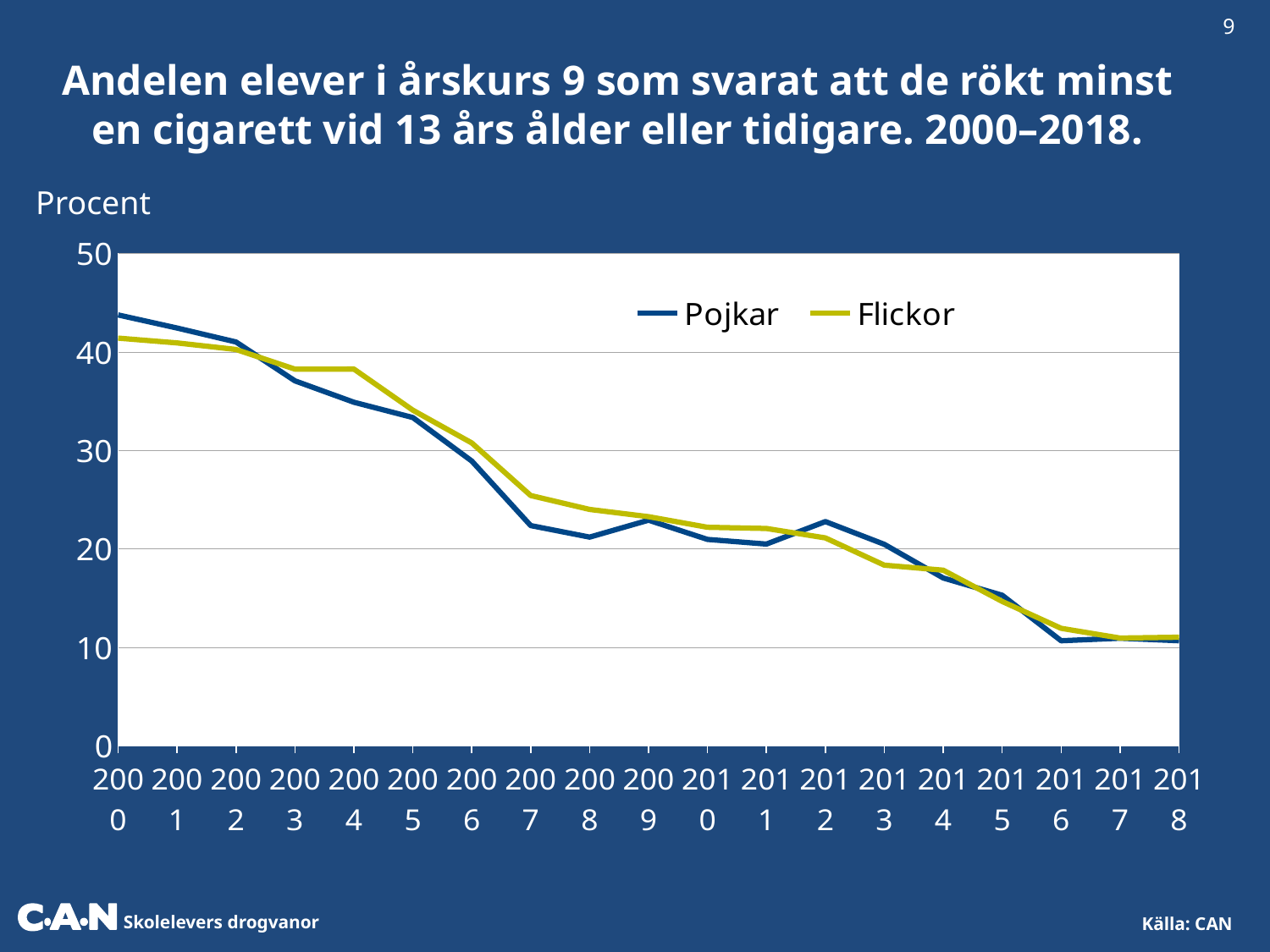
Do the values for Pojkar rise or fall from 2000 to 2018? Fall In which year is the value for Pojkar highest? 2000 Is the value for Pojkar in 2000 greater or less than 40? greater What kind of chart is shown on the slide? Line chart Is the value for Flickor in 2004 greater or less than 40? less How many series does the legend list? 2 How many years are plotted along the x axis? 19 In 2012, which series has the higher value, Pojkar or Flickor? Pojkar Is the value for Pojkar in 2007 greater or less than 20? greater What are the two series named in the legend? Pojkar and Flickor In 2004, which series has the higher value, Pojkar or Flickor? Flickor